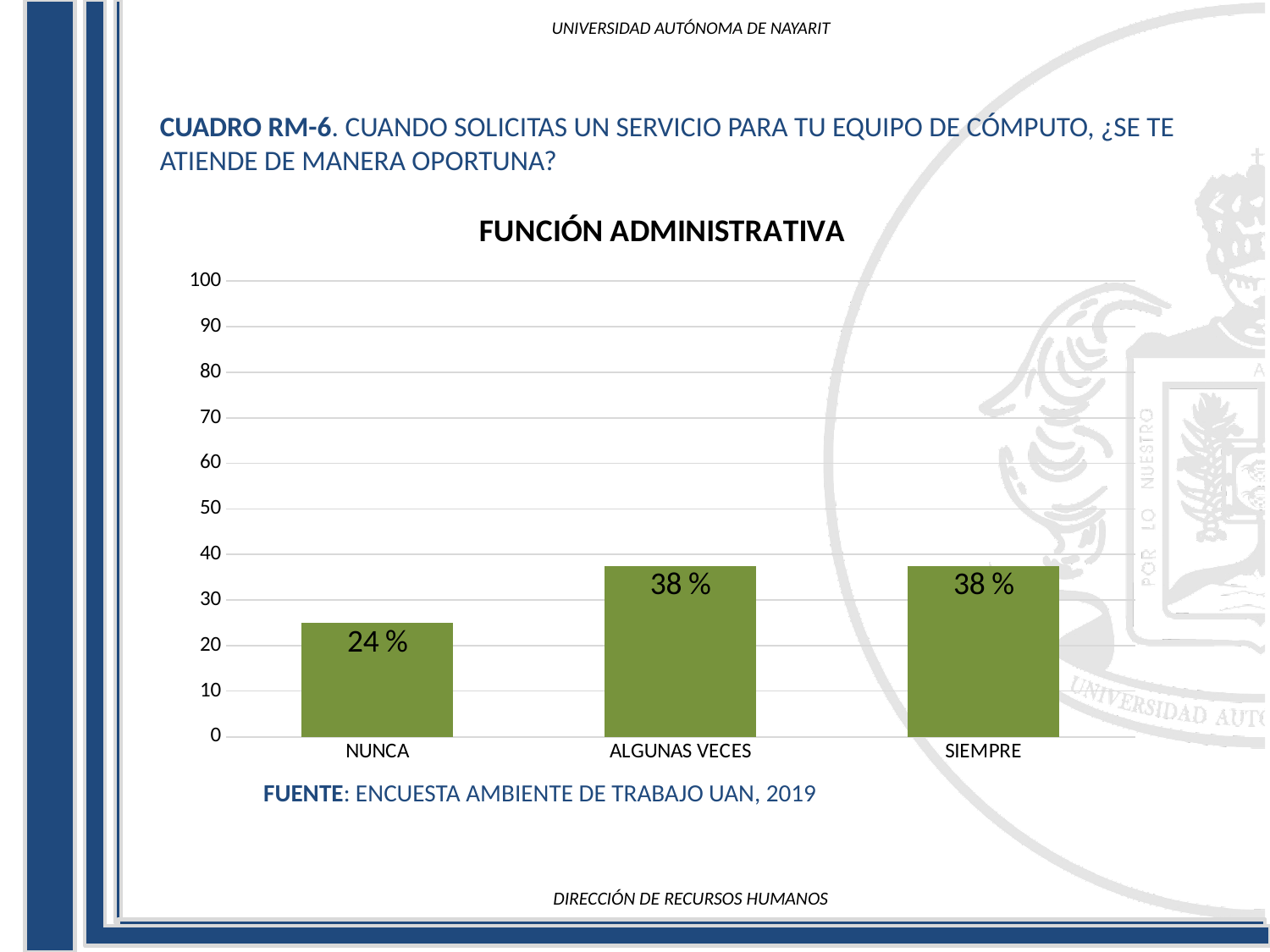
What is the maximum value shown on the y axis? 100 What is the title of the chart? FUNCIÓN ADMINISTRATIVA What is the value for NUNCA? 24 % Is the value for NUNCA greater or less than 30? less Which is larger, the value for NUNCA or the value for SIEMPRE? SIEMPRE What is the value for ALGUNAS VECES? 38 % What is the difference between the values for ALGUNAS VECES and NUNCA? 14 % Is the value for SIEMPRE greater or less than 30? greater What kind of chart is shown on the slide? bar chart What is the value for SIEMPRE? 38 % How many categories are shown on the x axis? 3 Which category has the lowest value? NUNCA